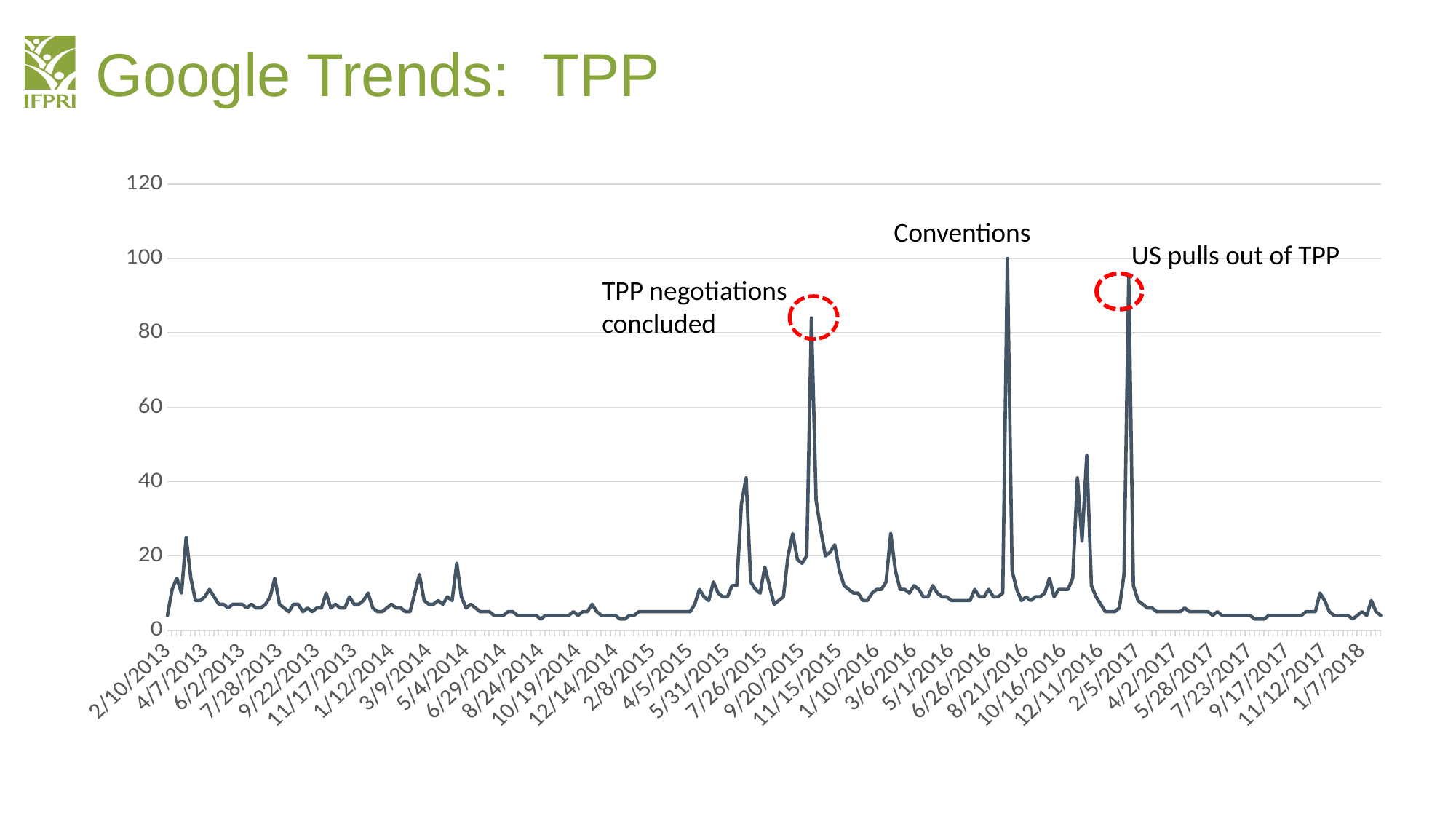
What kind of chart is shown on the slide? line chart What is the maximum value shown on the y axis? 120 What is the title of the slide containing the chart? Google Trends: TPP Is the peak labelled "US pulls out of TPP" greater or less than 80? greater Which peak is higher: "Conventions" or "TPP negotiations concluded"? Conventions Which peak is higher: "US pulls out of TPP" or "TPP negotiations concluded"? US pulls out of TPP Which annotated event corresponds to the highest peak on the chart? Conventions Is the peak labelled "TPP negotiations concluded" greater or less than 80? greater After the "US pulls out of TPP" peak in early 2017, do the values generally rise or fall through the end of the series? fall Is the peak labelled "TPP negotiations concluded" greater or less than 100? less What value does the peak labelled "Conventions" reach on the y axis? 100